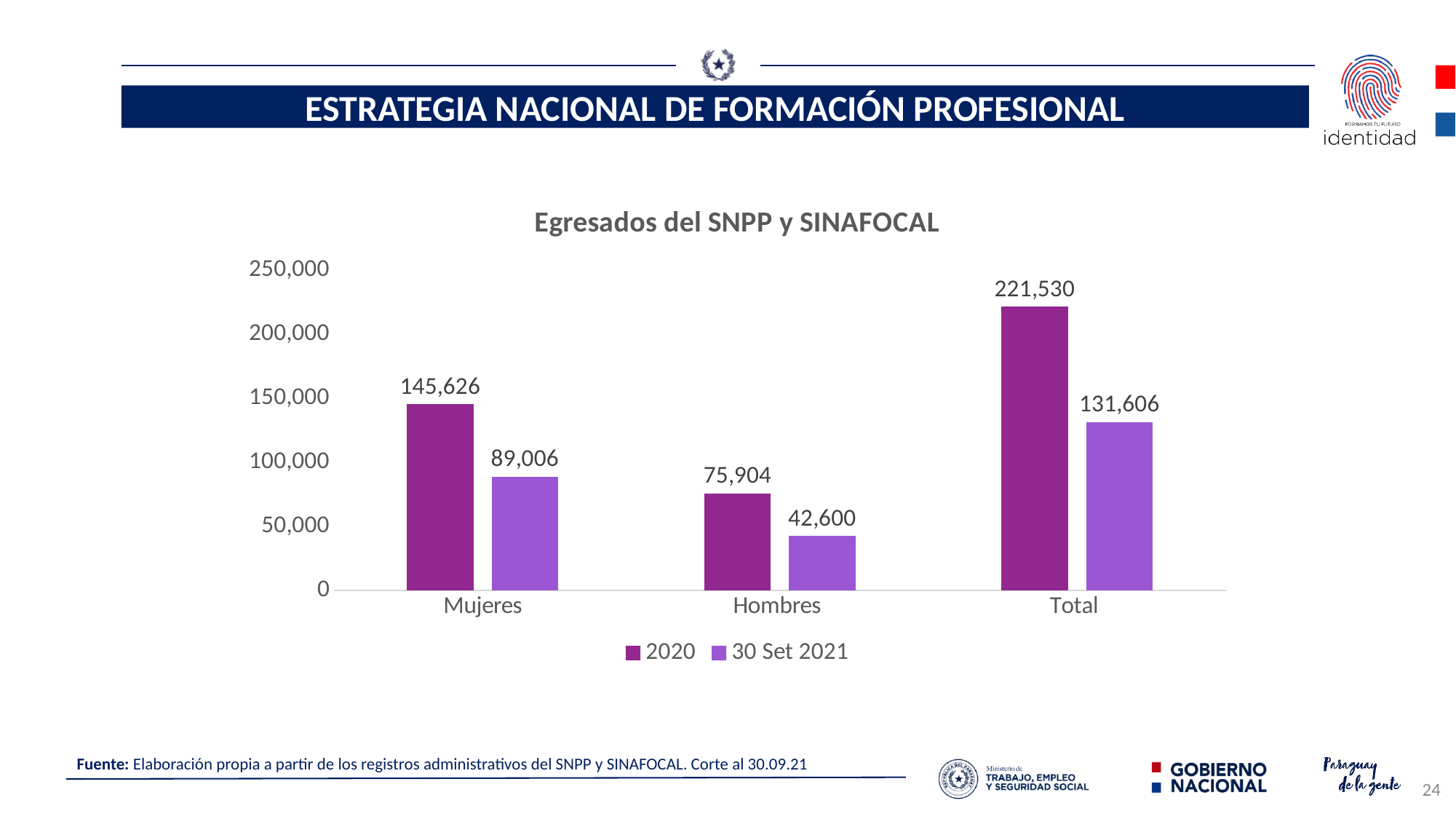
Which category has the lowest value in the 30 Set 2021 series? Hombres Which category has the highest value in the 2020 series? Total How many categories are shown on the x axis? 3 What is the difference between the 2020 and 30 Set 2021 values for Mujeres? 56,620 What is the value for Mujeres in the 30 Set 2021 series? 89,006 What is the value for Hombres in the 30 Set 2021 series? 42,600 What is the title of the chart? Egresados del SNPP y SINAFOCAL Which is larger: the 2020 value for Hombres or the 30 Set 2021 value for Mujeres? 30 Set 2021 value for Mujeres What is the difference between the 2020 and 30 Set 2021 values for Total? 89,924 What is the value for Total in the 2020 series? 221,530 How many series does the legend list? 2 What is the value for Mujeres in the 2020 series? 145,626